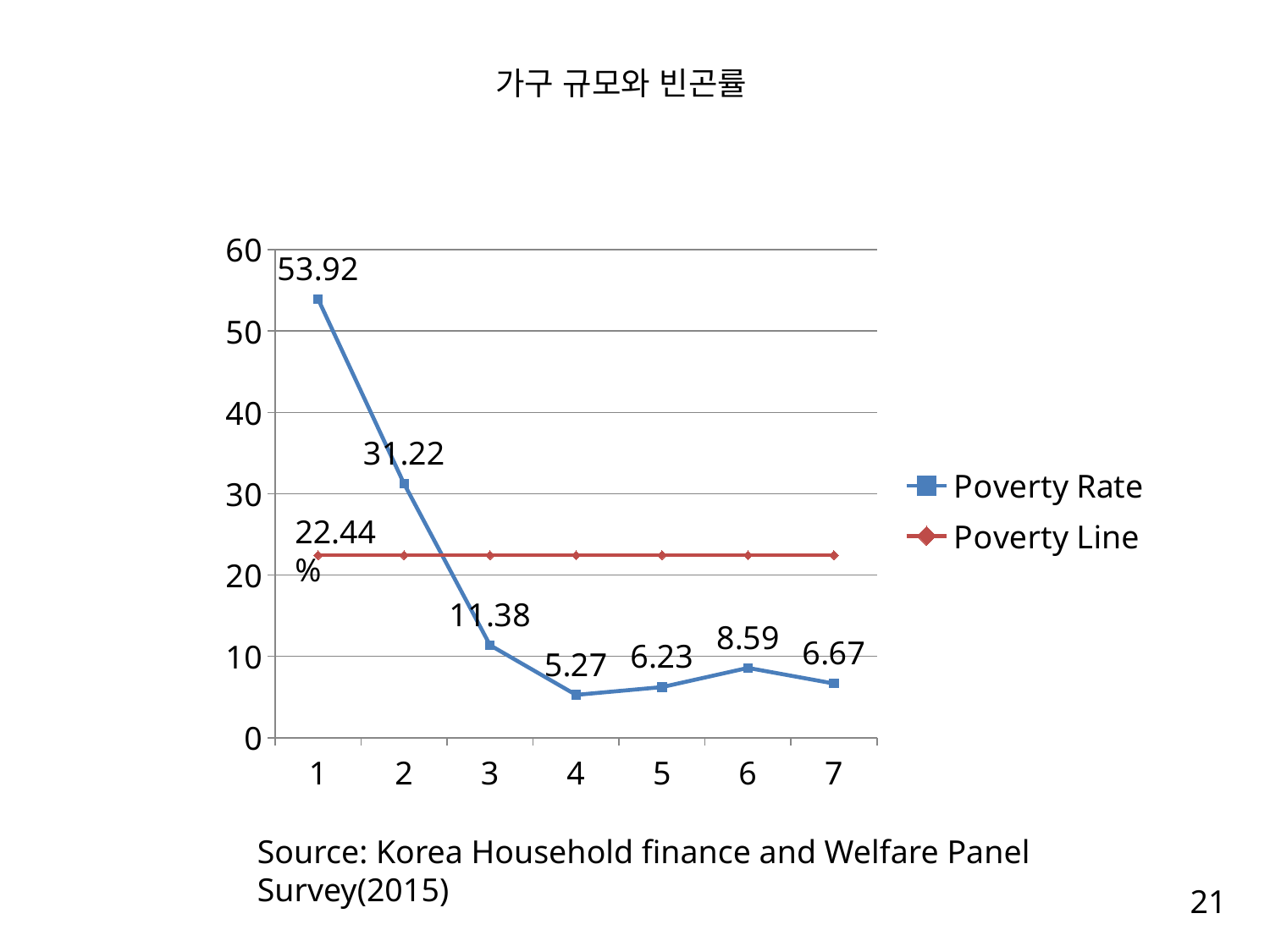
Which is larger, the Poverty Rate for household size 5 or household size 7? household size 7 What is the Poverty Rate for household size 6? 8.59 Is the Poverty Rate for household size 2 greater or less than 30? greater How many series does the legend list? 2 Does the Poverty Rate rise or fall from household size 1 to household size 4? fall What is the Poverty Rate for household size 3? 11.38 Which household size has the lowest Poverty Rate? 4 What is the difference between the Poverty Rate for household size 1 and household size 2? 22.7 What is the Poverty Rate for household size 1? 53.92 How many household size categories are shown on the x axis? 7 What kind of chart is shown on the slide? line chart Which household size has the highest Poverty Rate? 1